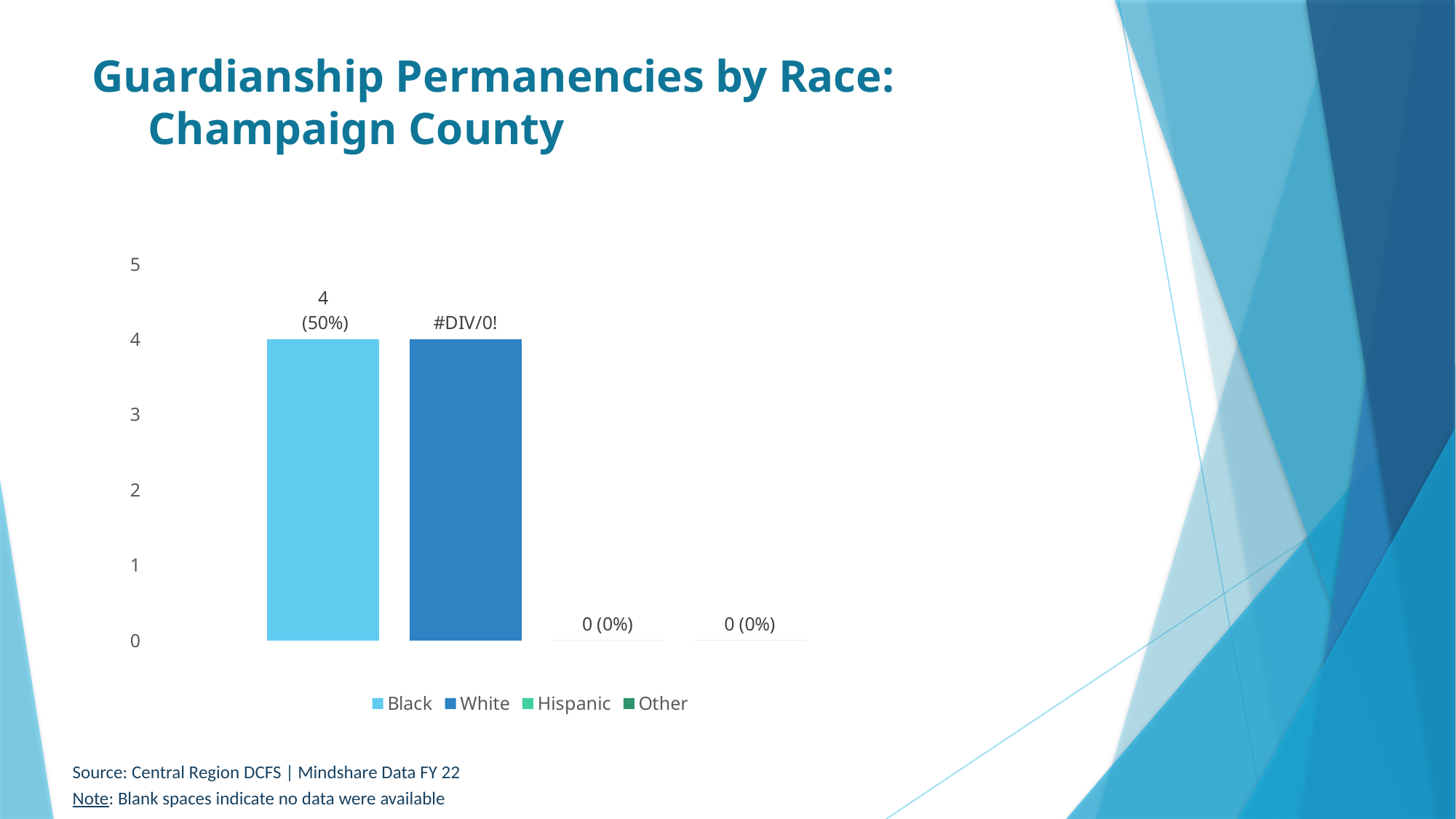
What kind of chart is shown on the slide? Bar chart What is the value shown for Black? 4 What is the value shown for Hispanic? 0 (0%) Which category has the lowest value, Black or Hispanic? Hispanic How many series does the legend list? 4 What is the title of the slide? Guardianship Permanencies by Race: Champaign County What percentage is shown in the data label for Black? 50% What does the data label above the White bar read? #DIV/0! Which is larger, the value for Black or the value for Other? Black What is the value shown for Other? 0 (0%) Is the value for the White bar greater or less than 3? greater What is the highest value shown on the vertical axis? 5